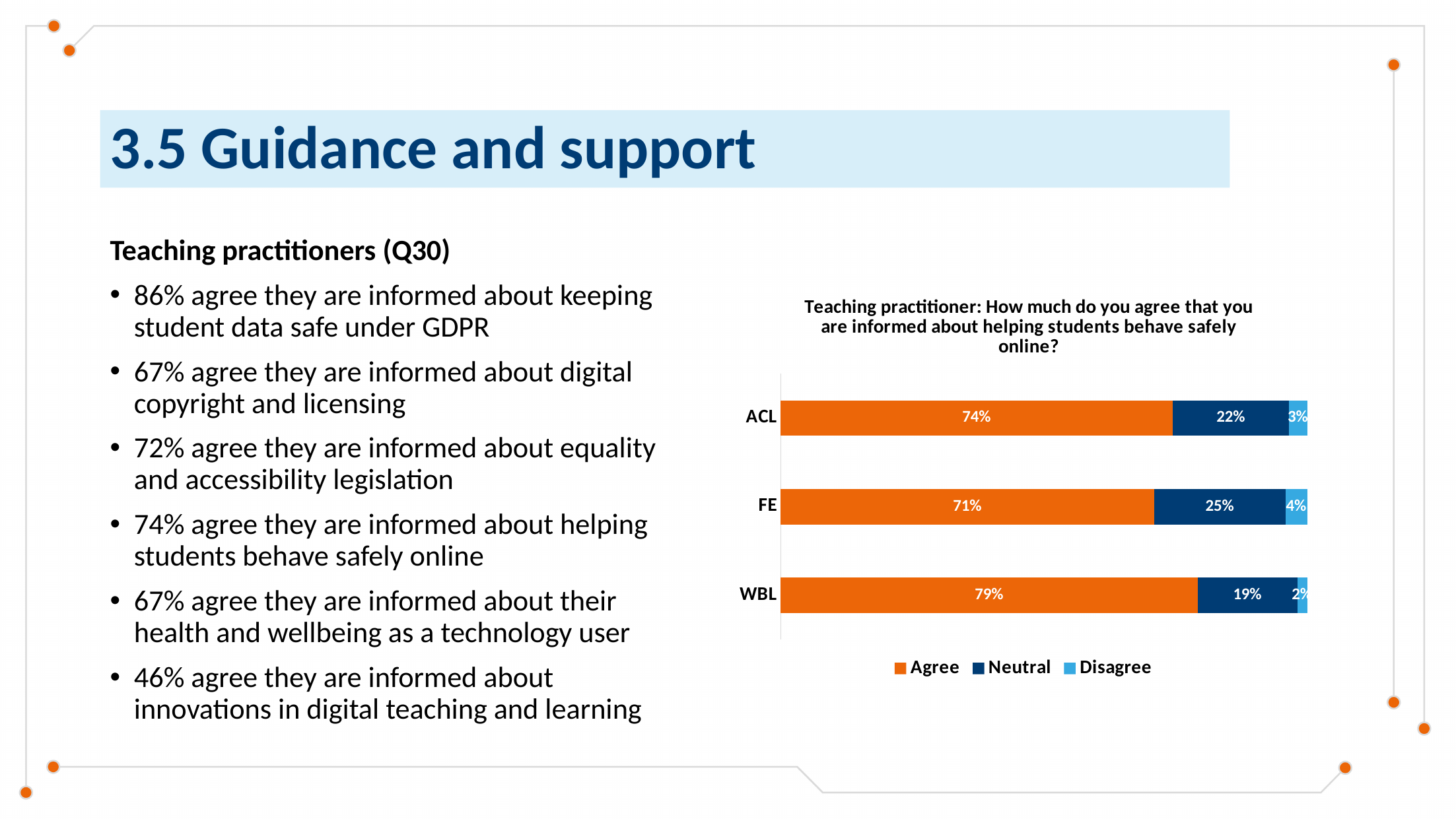
What is the difference between the Agree percentages for WBL and FE? 8% Which colour represents the Agree series in the chart? Orange Which category has the lowest Agree percentage? FE What is the Disagree value for WBL in the chart? 2% How many categories are shown on the chart? 3 What percentage of ACL teaching practitioners agree they are informed about helping students behave safely online? 74% What kind of chart is shown on the slide? Stacked bar chart Which category has the highest Agree percentage? WBL What is the total of the ACL bar (Agree + Neutral + Disagree)? 99% What is the Neutral value for FE in the chart? 25% Which has a larger Neutral percentage, ACL or WBL? ACL How many series does the chart legend list? 3